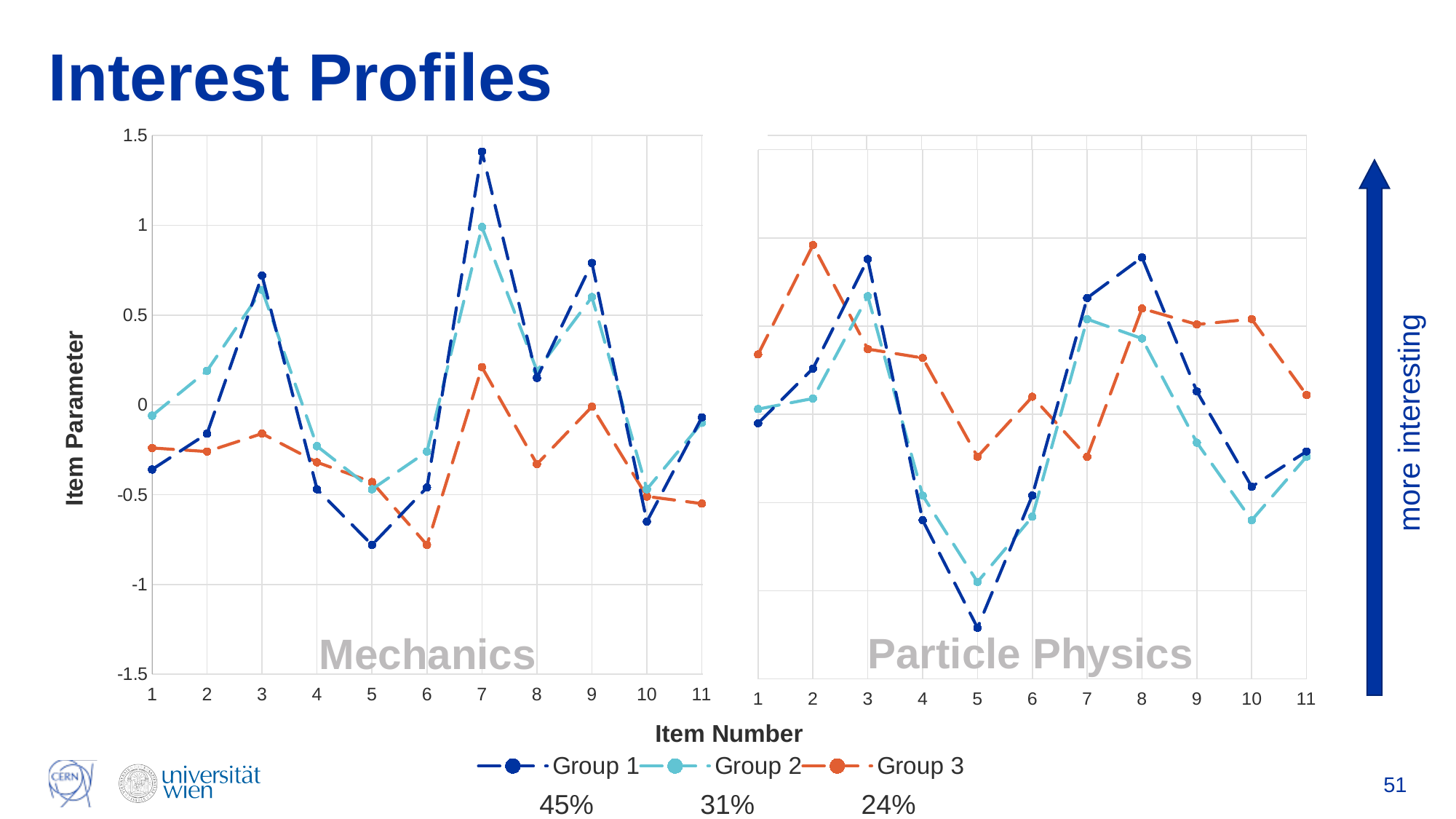
What is the title of the y axis on the Mechanics chart? Item Parameter In the Particle Physics chart, at which item number does Group 3 reach its highest value? 2 In the Mechanics chart, at which item number does Group 1 reach its highest value? 7 How many item numbers are shown on the x axis of the Particle Physics chart? 11 How many series does the legend list? 3 In the Mechanics chart, is the Group 3 value at item 6 greater or less than -0.5? less In the Particle Physics chart at item 2, which is larger: the Group 3 value or the Group 1 value? Group 3 In the Mechanics chart, is the Group 1 value at item 7 greater or less than 1? greater What kind of chart is the Mechanics chart? line chart In the Mechanics chart at item 7, which is larger: the Group 1 value or the Group 3 value? Group 1 In the Particle Physics chart, at which item number does Group 1 reach its lowest value? 5 In the Particle Physics chart, is the Group 1 value at item 5 greater or less than -1? less